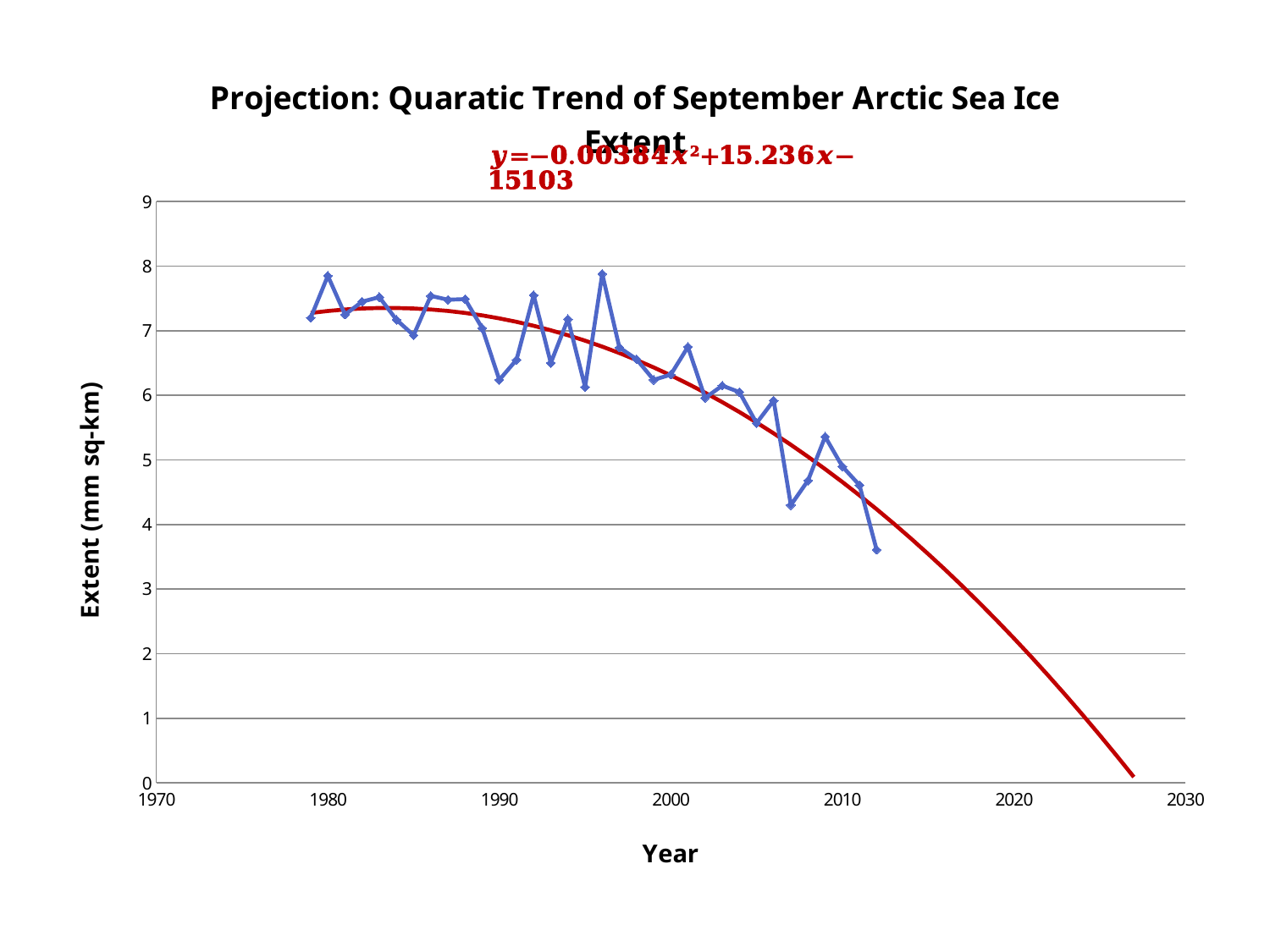
Overall, do the plotted sea ice extent values rise or fall from 1979 to 2012? fall What is the title of the chart? Projection: Quaratic Trend of September Arctic Sea Ice Extent What equation is printed in red on the chart for the trend line? y=−0.00384x²+15.236x−15103 Is the plotted value for 1980 greater or less than 7? greater What kind of chart is shown on the slide? line chart Which year has the lowest plotted sea ice extent? 2012 Is the plotted value for 1996 greater or less than 7? greater Is the plotted value for 2012 greater or less than 4? less Is the plotted value for 2012 larger or smaller than the plotted value for 2007? smaller